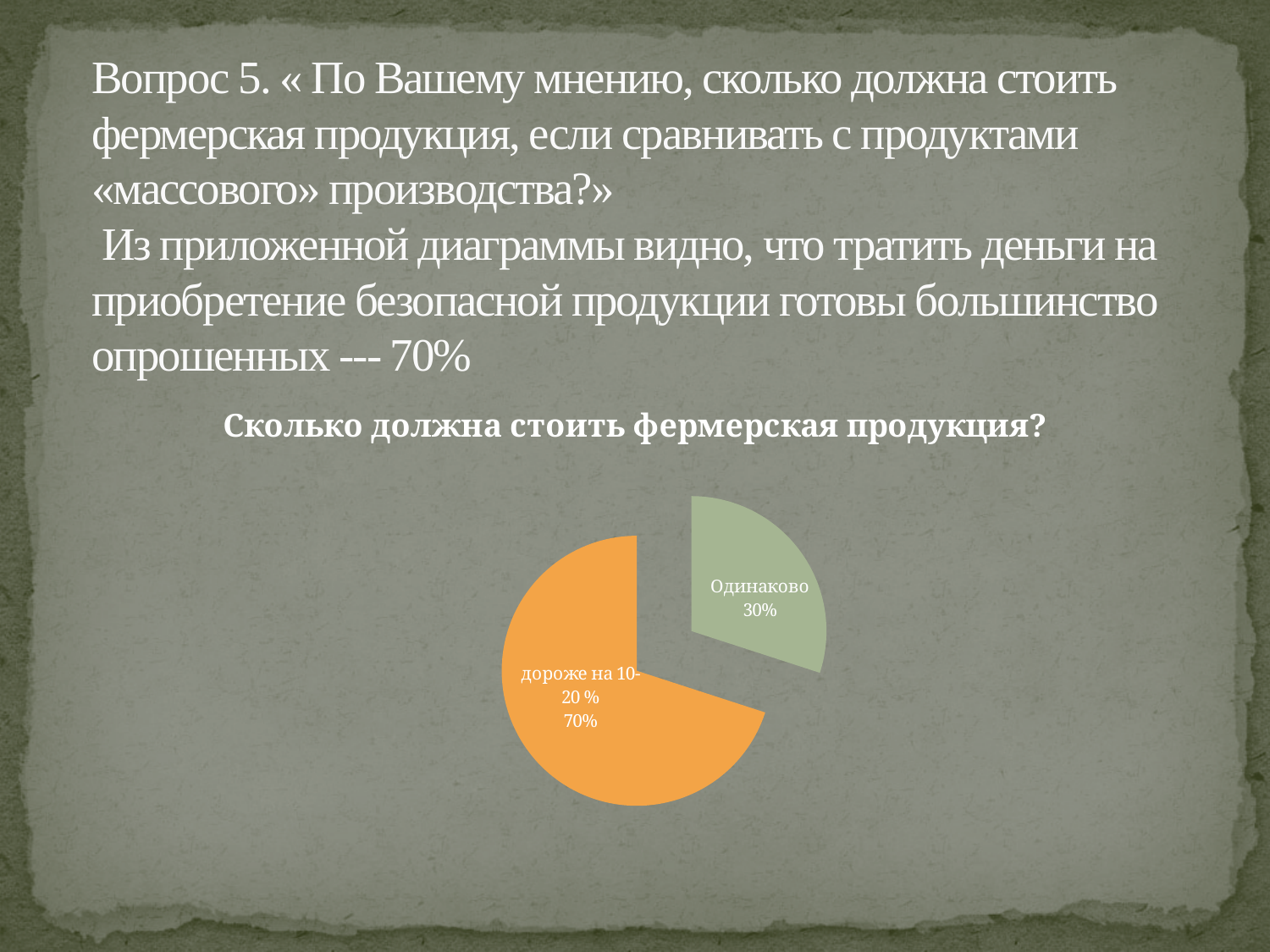
Which is larger: the "Одинаково" slice or the "дороже на 10-20 %" slice? дороже на 10-20 % How many slices does the pie chart have? 2 Which slice of the pie is the smallest? Одинаково What colour is the "дороже на 10-20 %" slice? orange What type of chart is shown on the slide? pie chart What share of the pie does the "дороже на 10-20 %" slice represent? 70% What is the difference in percentage points between the "дороже на 10-20 %" slice and the "Одинаково" slice? 40% Which slice of the pie is the largest? дороже на 10-20 % What is the title of the chart? Сколько должна стоить фермерская продукция? What share of the pie does the "Одинаково" slice represent? 30%